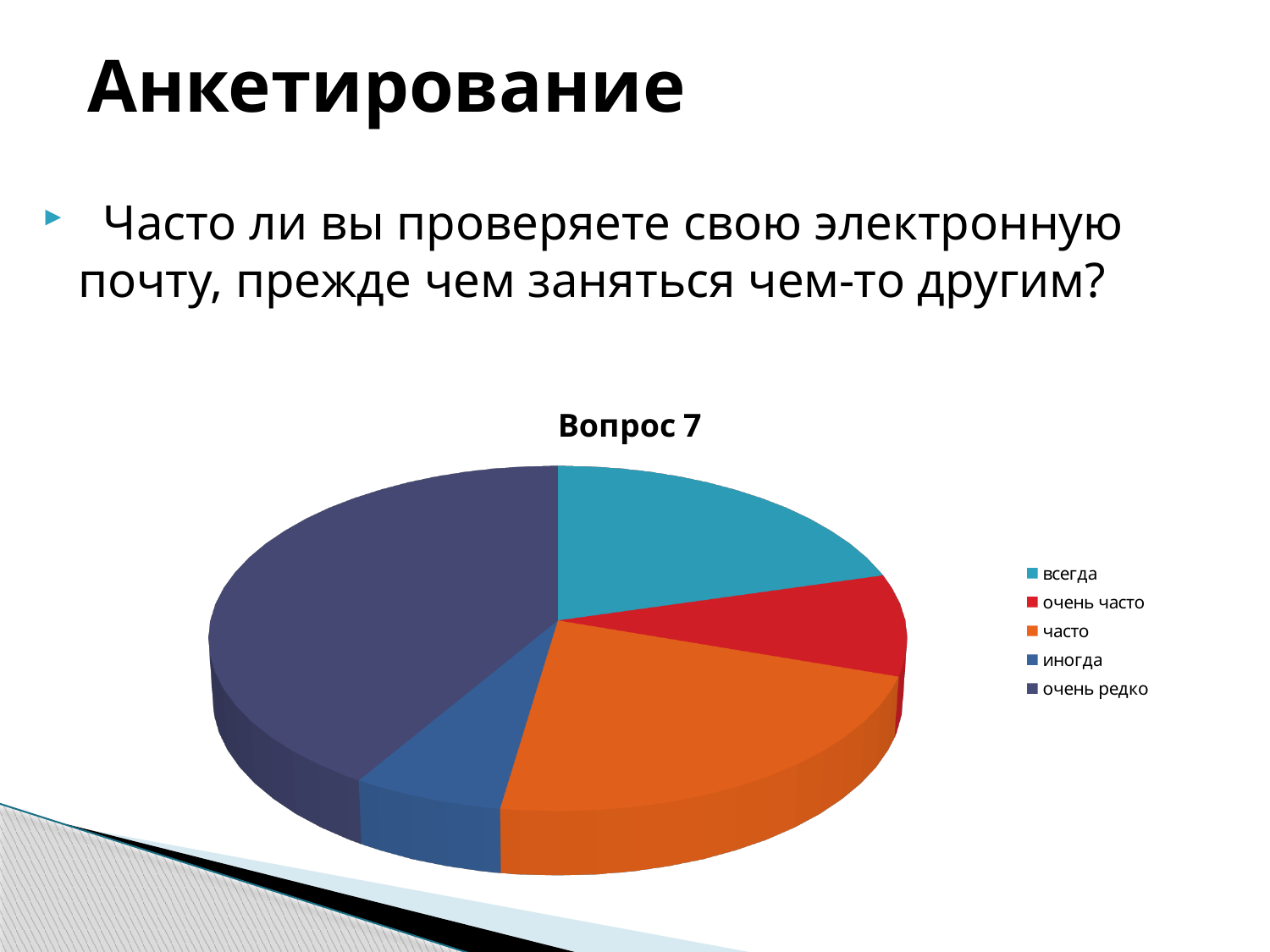
Which slice is larger, "всегда" or "иногда"? всегда Which category has the largest slice of the pie? очень редко Which slice is larger, "очень редко" or "часто"? очень редко Which slice is larger, "всегда" or "очень часто"? всегда How many categories does the pie chart have? 5 What kind of chart is shown on the slide? pie chart How many entries does the legend list? 5 What is the title of the chart? Вопрос 7 Which category is shown in orange? часто